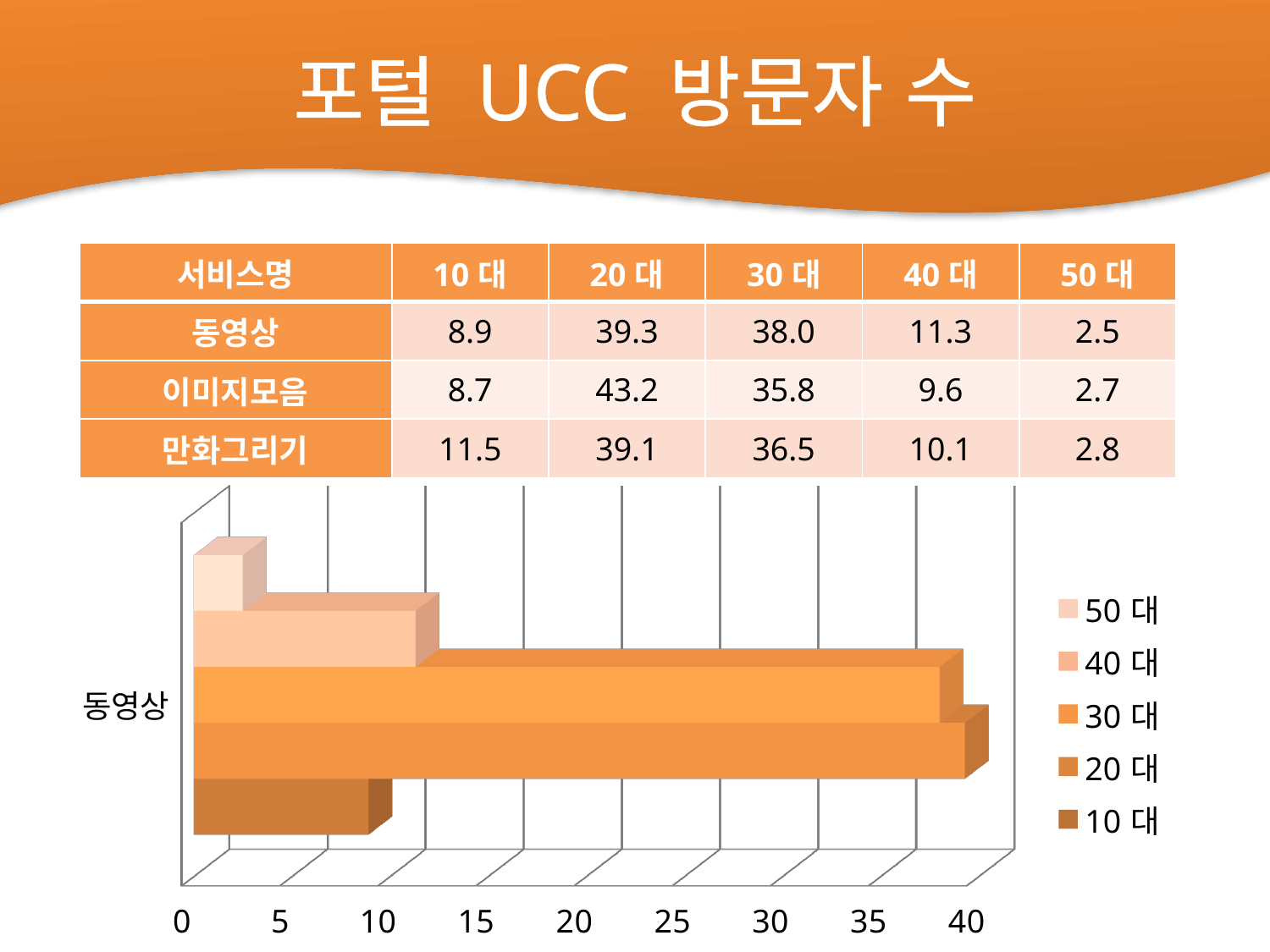
Which age group has the highest value for 동영상? 20 대 For 동영상, which is larger: the value for 10 대 or the value for 40 대? 40 대 What is the value for 10 대 in the 동영상 row of the table? 8.9 Which age group has the lowest value for 동영상? 50 대 In the chart, is the value for 10 대 greater or less than 10? less How many categories are plotted on the chart's vertical axis? 1 What kind of chart is shown on the slide? bar chart For 동영상, what is the difference between the 20 대 value and the 30 대 value? 1.3 In the chart, is the value for 40 대 greater or less than 10? greater How many series does the chart legend list? 5 What is the value for 30 대 in the 동영상 row of the table? 38.0 What is the title of the slide? 포털 UCC 방문자 수